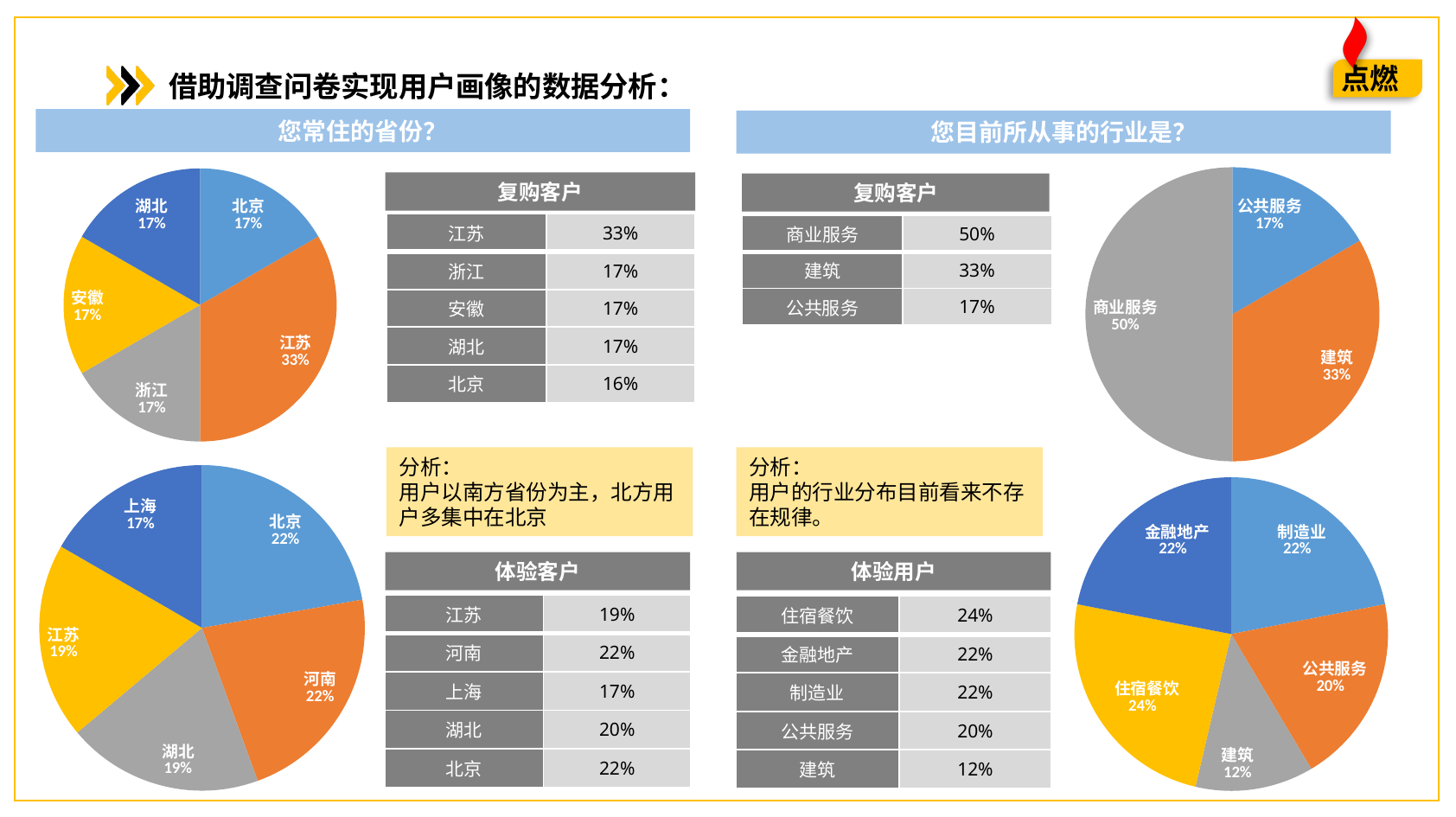
In the bottom-right pie chart (industries of trial users), which industry has the largest slice? 住宿餐饮 In the top-right pie chart (industries of repeat customers), which is larger, 建筑 or 公共服务? 建筑 In the bottom-right pie chart (industries of trial users), what share does 建筑 have? 12% How many slices does the top-left pie chart (provinces of repeat customers) have? 5 In the bottom-left pie chart (provinces of trial customers), what is the difference between the shares of 河南 and 湖北? 3% In the top-left pie chart (provinces of repeat customers), what share does 江苏 have? 33% In the top-right pie chart (industries of repeat customers), what share does 商业服务 have? 50% In the bottom-left pie chart (provinces of trial customers), which province has the smallest slice? 上海 How many slices does the top-right pie chart (industries of repeat customers) have? 3 In the top-left pie chart (provinces of repeat customers), which province has the largest slice? 江苏 What type of chart is used in the bottom-right chart (industries of trial users)? Pie chart In the bottom-left pie chart (provinces of trial customers), what share does 上海 have? 17%